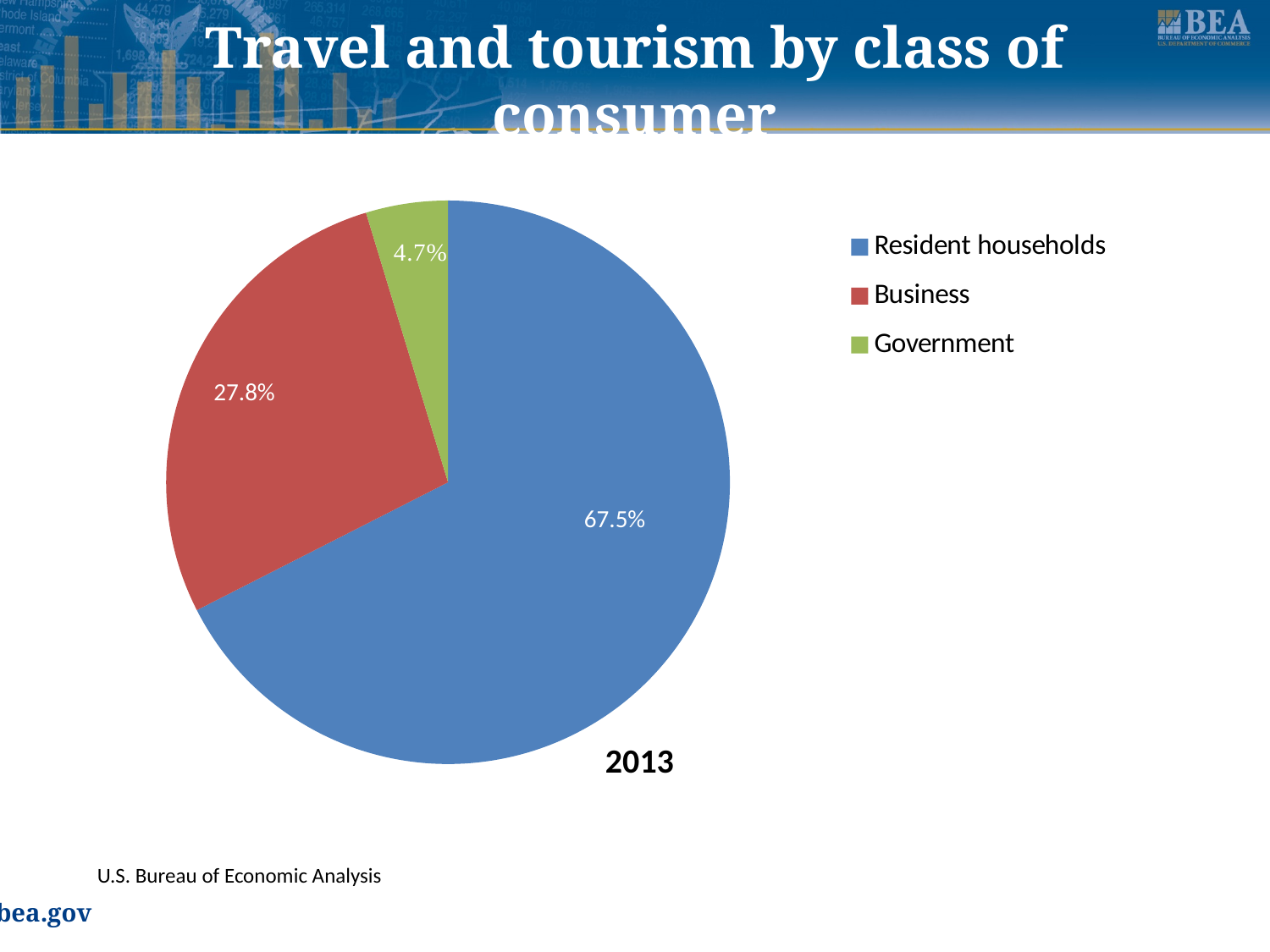
What is the difference in percentage points between the Business share and the Government share? 23.1 What type of chart is shown on the slide? Pie chart Which class of consumer has the smallest share of the pie? Government Which class of consumer has the largest share of the pie? Resident households How many slices does the pie chart have? 3 What share of travel and tourism is attributed to Government? 4.7% Which is larger, the Business share or the Government share? Business What year is labelled on the chart? 2013 What share of travel and tourism is attributed to Business? 27.8% How many entries does the legend list? 3 What share of travel and tourism is attributed to Resident households? 67.5% What is the difference in percentage points between the Resident households share and the Business share? 39.7